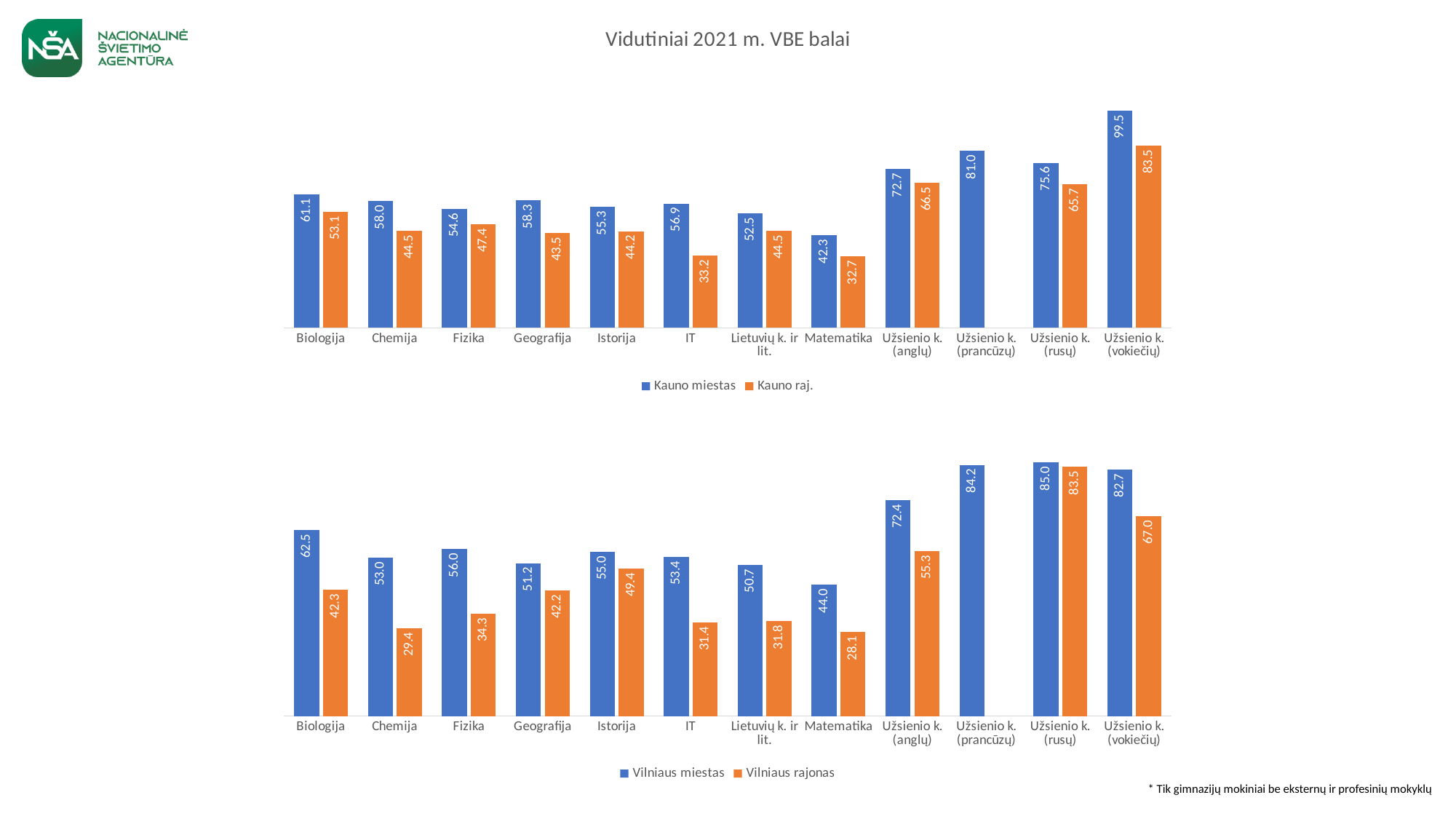
In the bottom chart, which category has the highest value for Vilniaus miestas? Užsienio k. (rusų) In the top chart, what is the difference between Kauno miestas and Kauno raj. in IT? 23.7 In the top chart, what is the value for Kauno miestas in Biologija? 61.1 In the bottom chart, what is the value for Vilniaus miestas in Užsienio k. (prancūzų)? 84.2 How many categories are shown on the x axis of the bottom chart? 12 In the bottom chart, what is the difference between Vilniaus miestas and Vilniaus rajonas in Užsienio k. (anglų)? 17.1 How many series does the legend of the top chart list? 2 In the bottom chart, what is the value for Vilniaus rajonas in Chemija? 29.4 In the top chart, what is the value for Kauno raj. in Matematika? 32.7 In the top chart, which category has the lowest value for Kauno raj.? Matematika In the bottom chart, which is larger in Istorija: Vilniaus miestas or Vilniaus rajonas? Vilniaus miestas In the top chart, which category has the highest value for Kauno miestas? Užsienio k. (vokiečių)